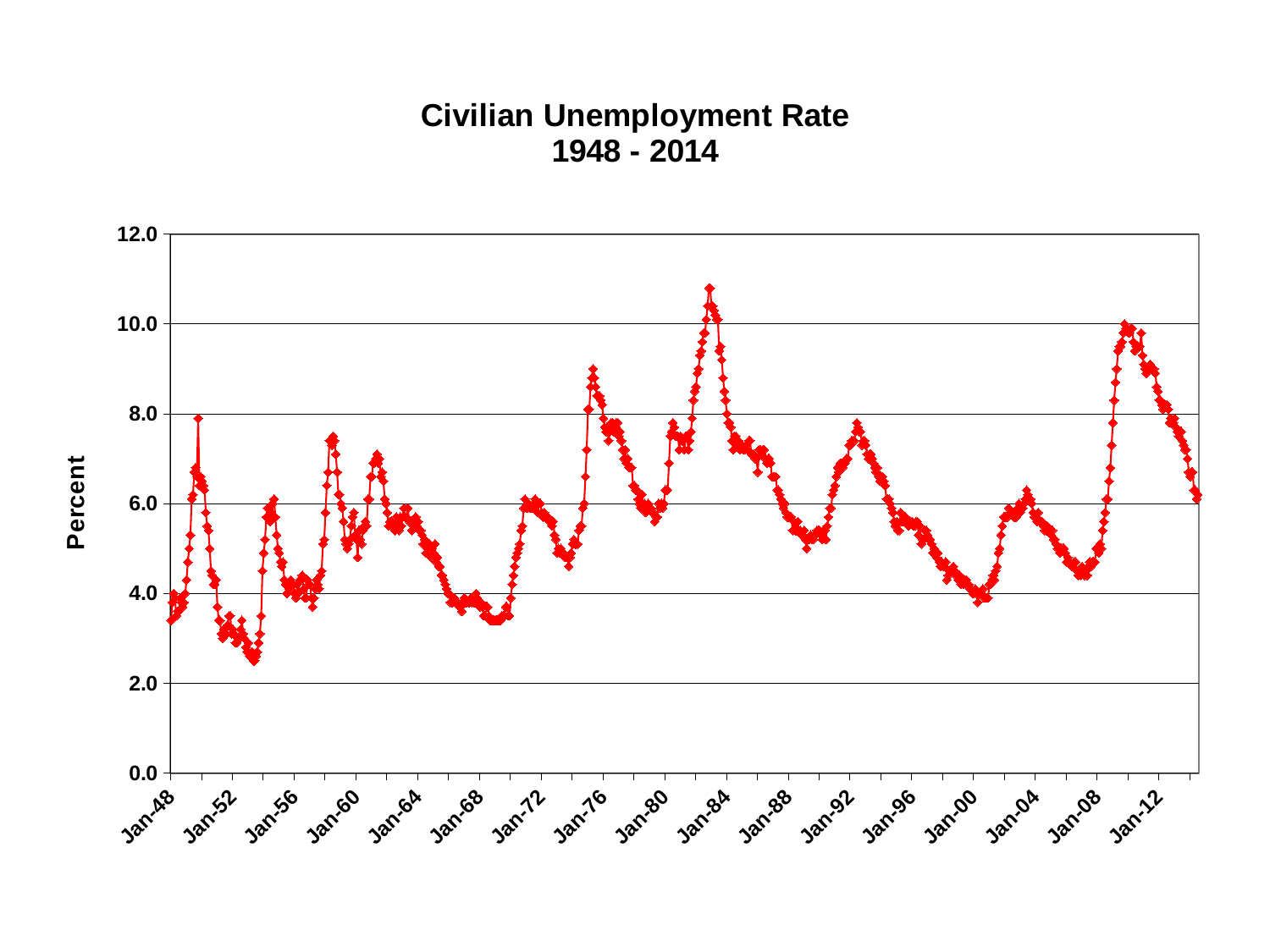
Is the value at Jan-92 greater or less than 6.0? greater In which period does the unemployment rate reach its highest point on the chart: around 1982-1983 or around 2009-2010? around 1982-1983 Is the value at Jan-00 greater or less than 5.0? less What is the title of the chart? Civilian Unemployment Rate 1948 - 2014 What kind of chart is shown on the slide? line chart What is the label on the vertical axis of the chart? Percent Is the lowest point on the chart found in the early 1950s or in the early 2000s? early 1950s Is the value at Jan-48 greater or less than 6.0? less Between Jan-08 and Jan-10, does the unemployment rate rise or fall? rise From Jan-12 to the end of the series, does the unemployment rate rise or fall? fall